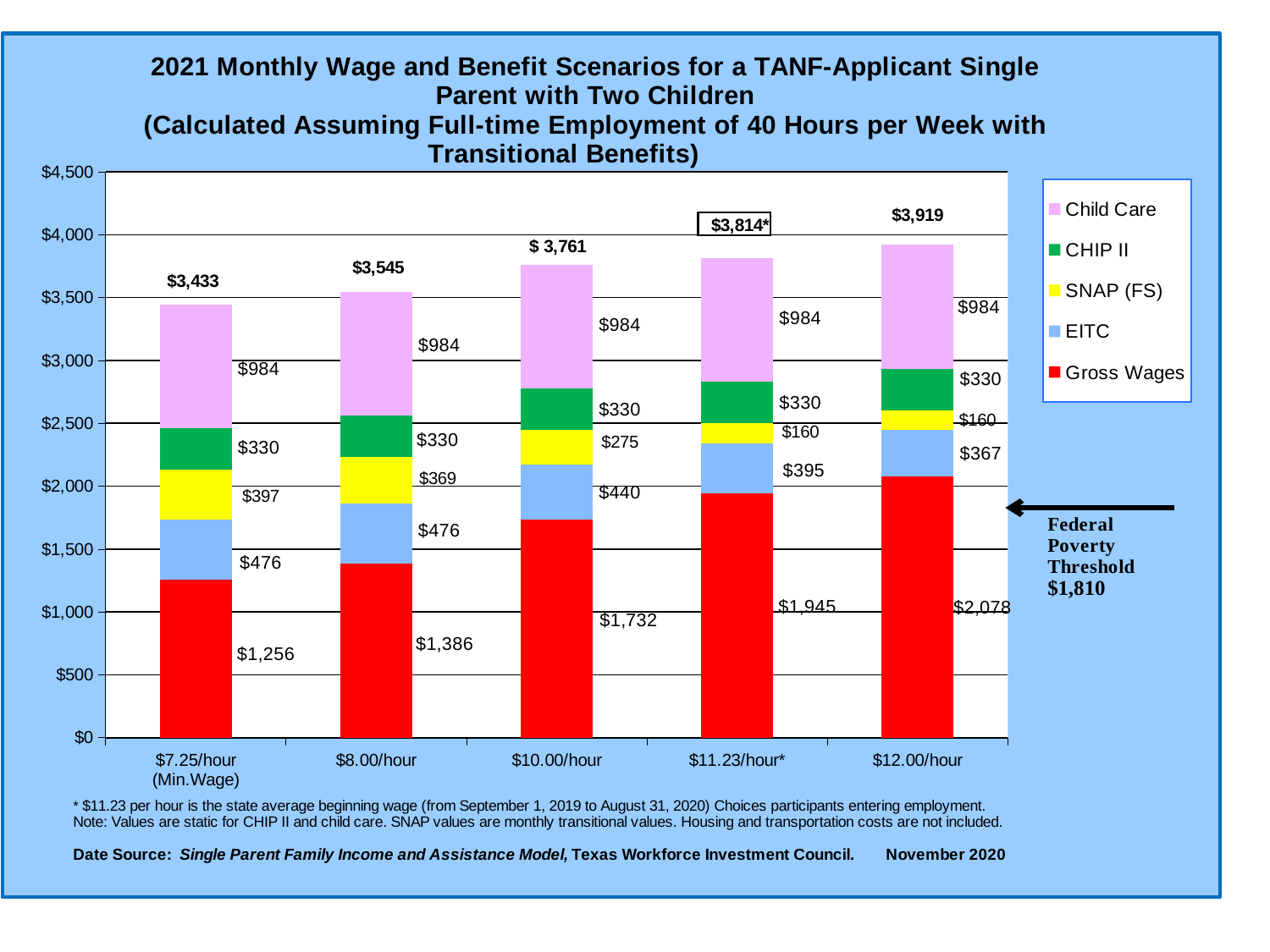
Which wage scenario has the highest total monthly wage and benefits? $12.00/hour What is the total of the stacked bar for the $12.00/hour scenario? $3,919 What is the Gross Wages value for the $10.00/hour scenario? $1,732 What is the EITC value for the $11.23/hour* scenario? $395 What is the SNAP (FS) value for the $8.00/hour scenario? $369 What kind of chart is shown on the slide? Stacked bar chart How many series does the legend list? 5 How many wage scenarios are shown on the x axis? 5 Which scenario has the larger EITC value, $7.25/hour (Min.Wage) or $12.00/hour? $7.25/hour (Min.Wage) Do the Gross Wages values rise or fall as the hourly wage increases along the x axis? Rise Which wage scenario has the lowest total monthly wage and benefits? $7.25/hour (Min.Wage) What is the difference in Gross Wages between the $12.00/hour and $7.25/hour (Min.Wage) scenarios? $822